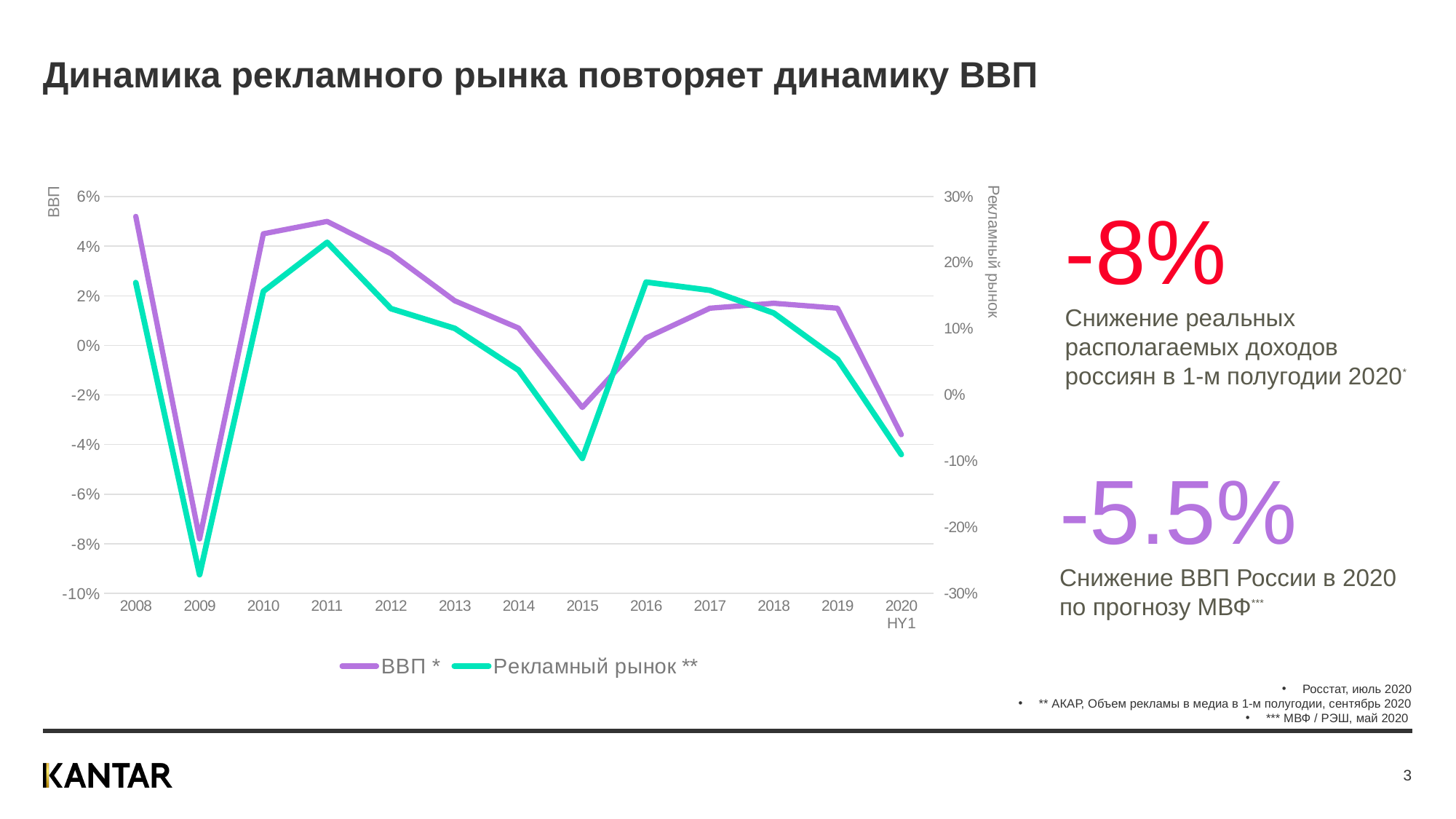
Is the value for Рекламный рынок ** in 2011 greater or less than 20%? greater What kind of chart is shown on the slide? Line chart Does the ВВП * series rise or fall from 2018 to 2020 HY1? fall Is the value for ВВП * in 2009 greater or less than -6%? less Is the value for Рекламный рынок ** in 2009 greater or less than -20%? less In which year does the Рекламный рынок ** series reach its highest value? 2011 In which year does the ВВП * series reach its lowest value? 2009 Which series is drawn in purple on the chart? ВВП * How many time points are plotted along the x axis of the chart? 13 In which year does the Рекламный рынок ** series reach its lowest value? 2009 How many series does the chart legend list? 2